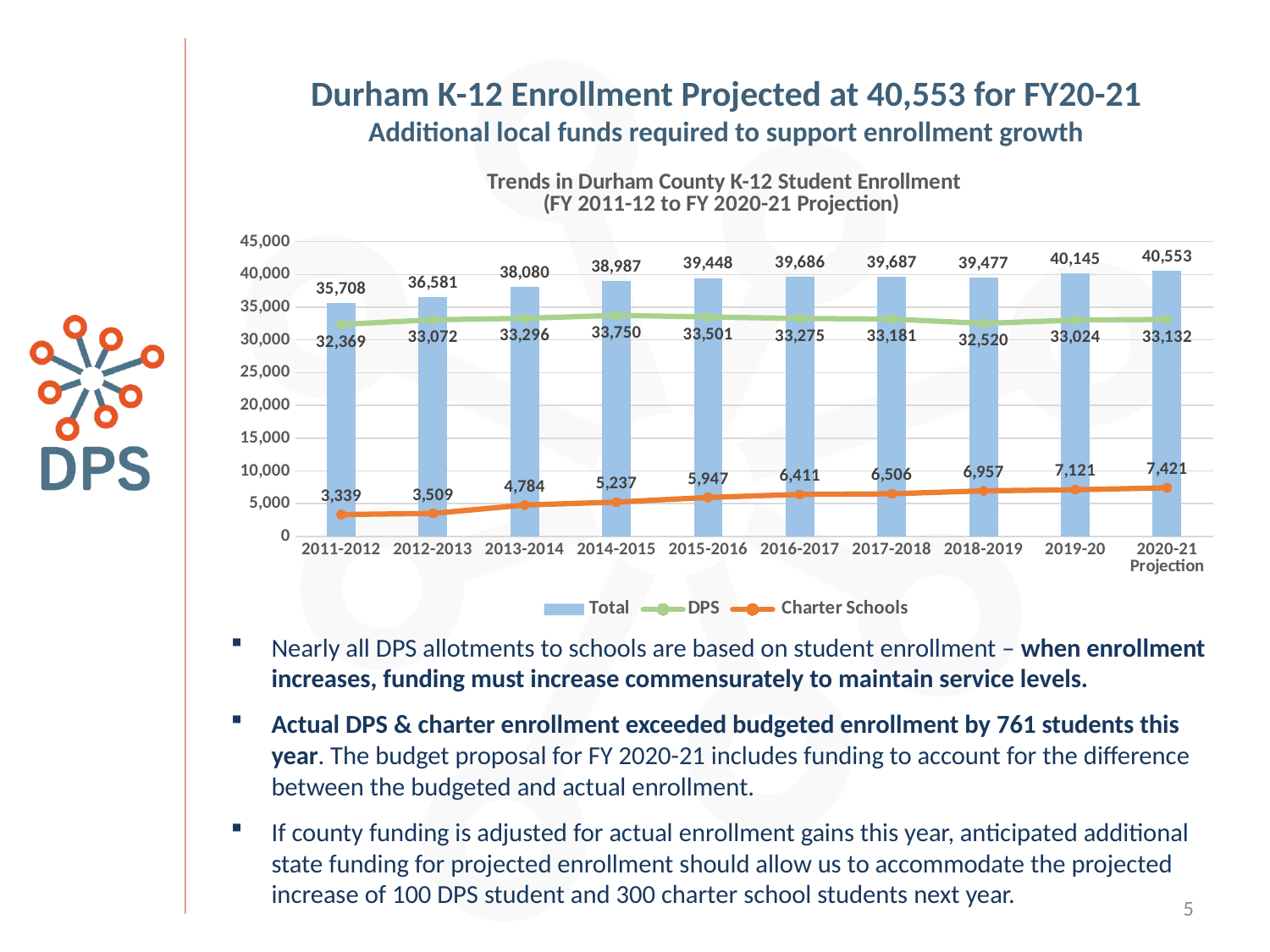
In which year is DPS enrollment lowest? 2011-2012 Does Charter Schools enrollment rise or fall from 2011-2012 to the 2020-21 Projection? rise How many series does the chart legend list? 3 What is the DPS enrollment for 2014-2015? 33,750 In which year is DPS enrollment highest? 2014-2015 What is the Charter Schools enrollment for 2018-2019? 6,957 What is the Total enrollment value for 2015-2016? 39,448 How much higher is the Total enrollment in the 2020-21 Projection than in 2011-2012? 4,845 In which year is Charter Schools enrollment lowest? 2011-2012 Which year has higher DPS enrollment, 2012-2013 or 2013-2014? 2013-2014 By how much does Charter Schools enrollment increase from 2019-20 to the 2020-21 Projection? 300 How many years are shown on the x axis of the chart? 10